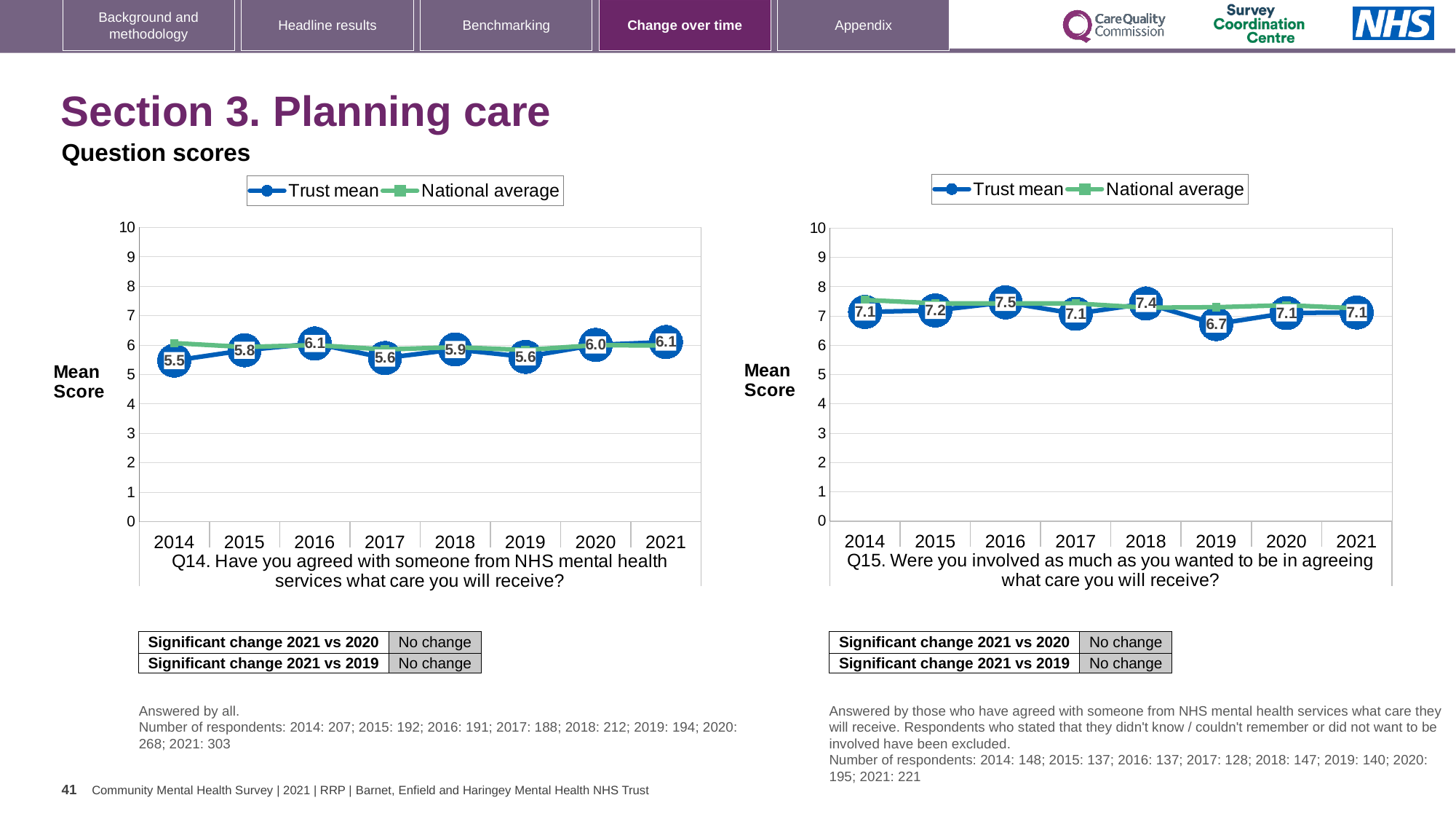
In the Q15 chart on the right, which year has the lowest Trust mean score? 2019 How many years are shown on the x axis of the Q15 chart on the right? 8 In the Q14 chart on the left, what is the Trust mean score for 2021? 6.1 In the Q15 chart on the right, what is the Trust mean score for 2019? 6.7 In the Q14 chart on the left, which year has the lowest Trust mean score? 2014 In the Q14 chart on the left, what is the Trust mean score for 2014? 5.5 How many series does the legend of the Q14 chart on the left list? 2 In the Q14 chart on the left, is the National average value for 2014 greater or less than 5? greater In the Q14 chart on the left, what is the difference between the Trust mean scores for 2021 and 2014? 0.6 In the Q15 chart on the right, which is larger, the Trust mean for 2016 or for 2018? 2016 In the Q15 chart on the right, which year has the highest Trust mean score? 2016 What type of chart is the Q15 chart on the right? Line chart